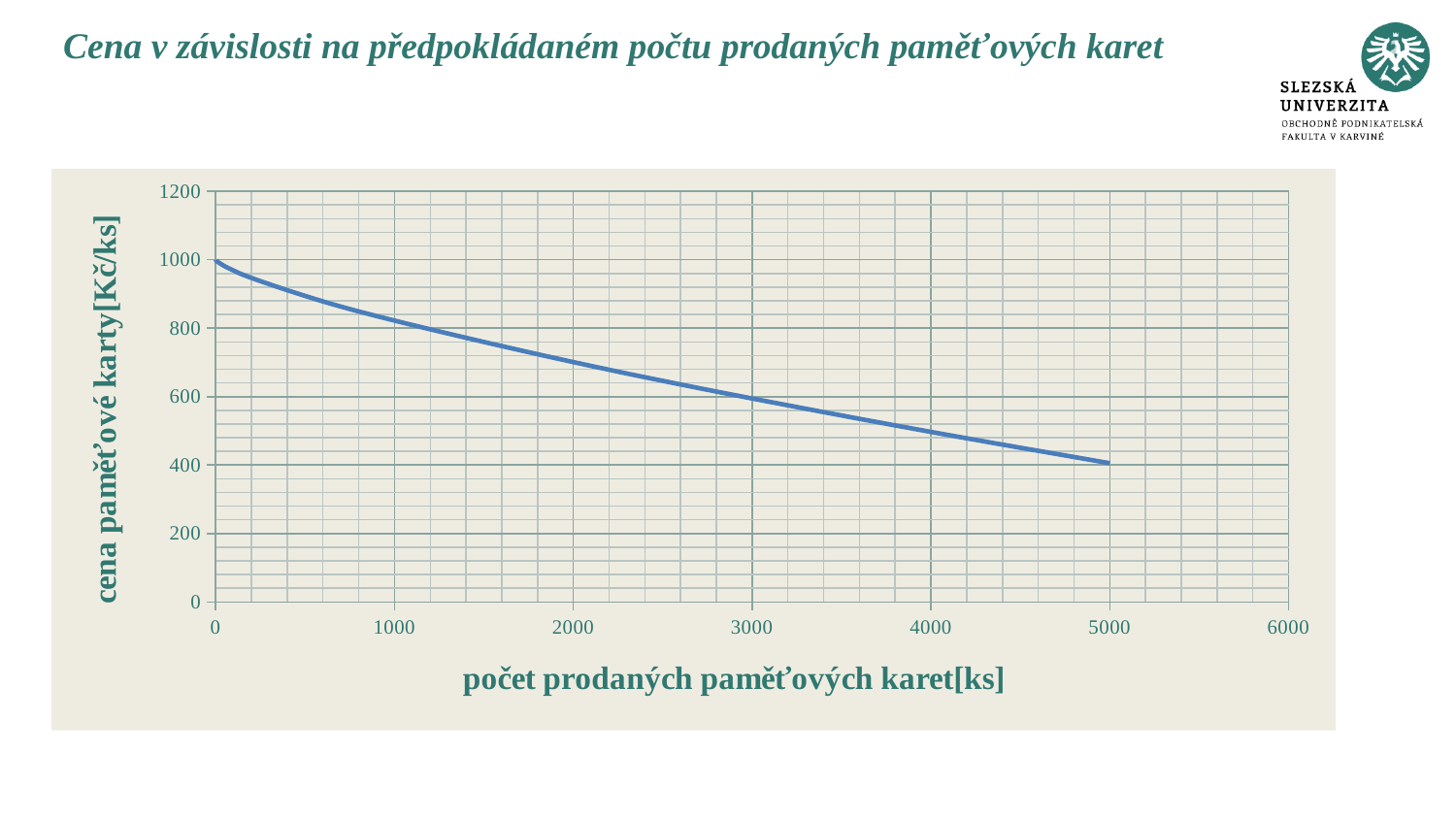
What kind of chart is shown on the slide? line chart Does the price of a memory card rise or fall as the number of sold cards increases along the x axis? fall Is the price at 4000 sold memory cards greater or less than 400 Kč/ks? greater Is the price at 5000 sold memory cards greater or less than 600 Kč/ks? less What is the label of the x axis? počet prodaných paměťových karet[ks] Is the price at 4000 sold memory cards greater or less than 600 Kč/ks? less Is the price at 1000 sold memory cards larger or smaller than the price at 3000 sold memory cards? larger What is the label of the y axis? cena paměťové karty[Kč/ks]